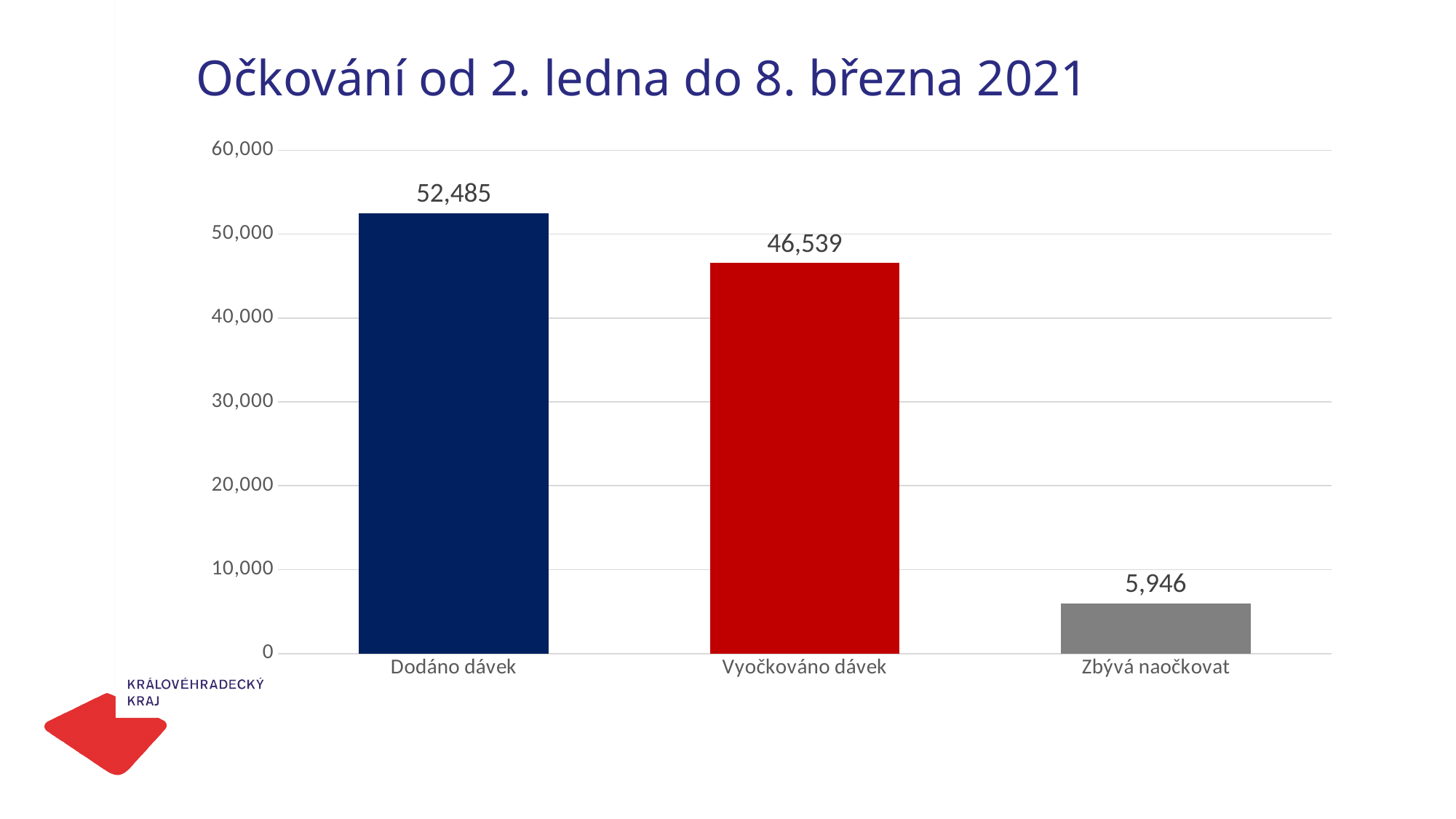
What kind of chart is shown on the slide? bar chart How many categories are shown in the chart? 3 Is the value for Vyočkováno dávek greater or less than 50,000? less What is the value for Vyočkováno dávek? 46,539 What is the value for Dodáno dávek? 52,485 What is the title of the chart? Očkování od 2. ledna do 8. března 2021 What is the difference between Vyočkováno dávek and Zbývá naočkovat? 40,593 What is the value for Zbývá naočkovat? 5,946 Which category has the highest value? Dodáno dávek Which is larger, Vyočkováno dávek or Zbývá naočkovat? Vyočkováno dávek What is the difference between Dodáno dávek and Vyočkováno dávek? 5,946 Which category has the lowest value? Zbývá naočkovat